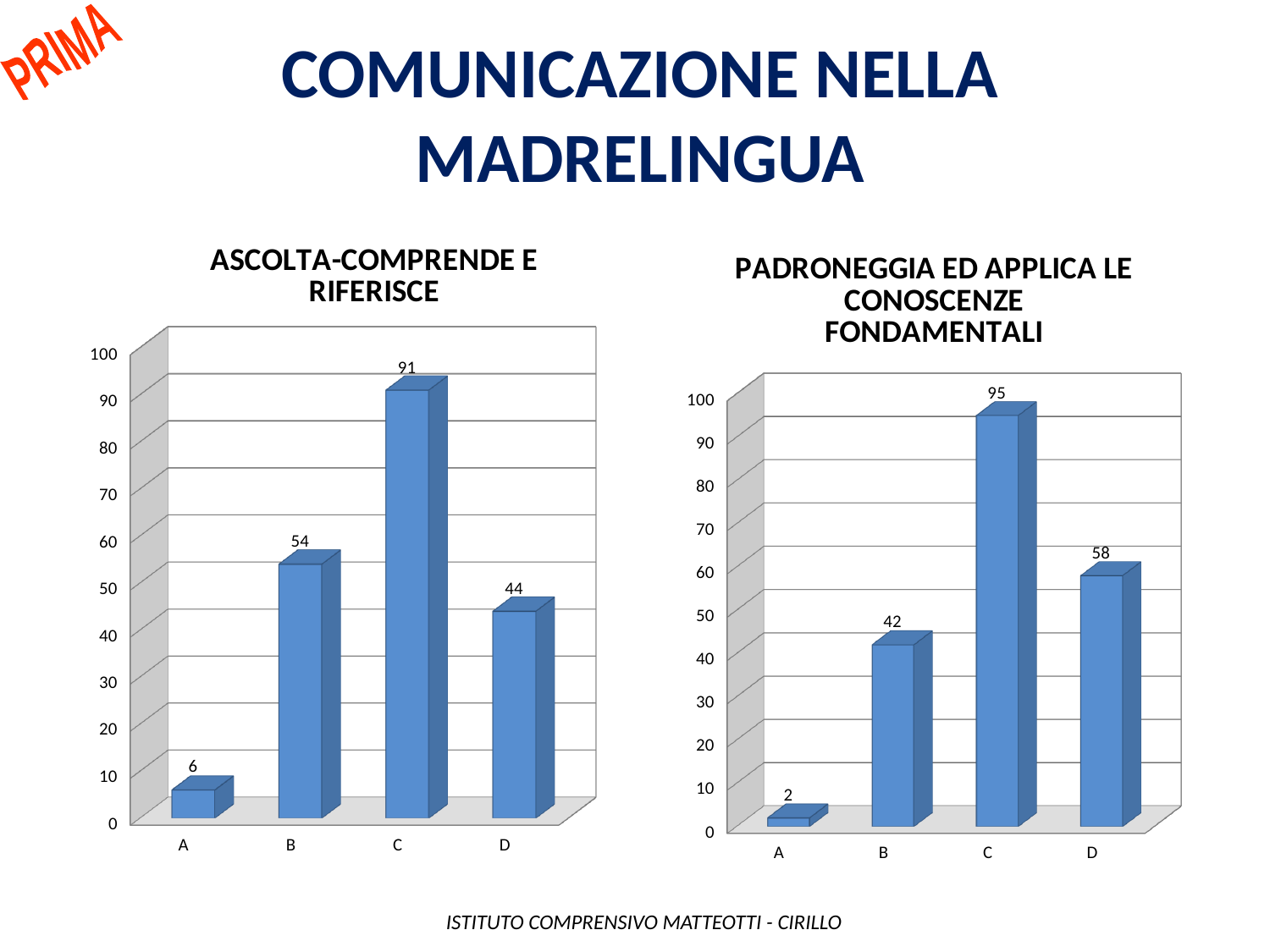
How many categories are shown in the 'PADRONEGGIA ED APPLICA LE CONOSCENZE FONDAMENTALI' chart? 4 In the 'ASCOLTA-COMPRENDE E RIFERISCE' chart, is the value for B greater or less than 50? greater What is the title of the chart on the right side of the slide? PADRONEGGIA ED APPLICA LE CONOSCENZE FONDAMENTALI In the 'PADRONEGGIA ED APPLICA LE CONOSCENZE FONDAMENTALI' chart, what is the value for category D? 58 What kind of chart is the 'ASCOLTA-COMPRENDE E RIFERISCE' chart? Bar chart In the 'ASCOLTA-COMPRENDE E RIFERISCE' chart, what is the value for category C? 91 In the 'ASCOLTA-COMPRENDE E RIFERISCE' chart, what is the value for category A? 6 In the 'ASCOLTA-COMPRENDE E RIFERISCE' chart, what is the difference between the values for B and D? 10 In the 'PADRONEGGIA ED APPLICA LE CONOSCENZE FONDAMENTALI' chart, which category has the highest value? C In the 'ASCOLTA-COMPRENDE E RIFERISCE' chart, which category has the lowest value? A In the 'PADRONEGGIA ED APPLICA LE CONOSCENZE FONDAMENTALI' chart, what is the difference between the values for C and B? 53 In the 'PADRONEGGIA ED APPLICA LE CONOSCENZE FONDAMENTALI' chart, which is larger, the value for B or the value for D? D